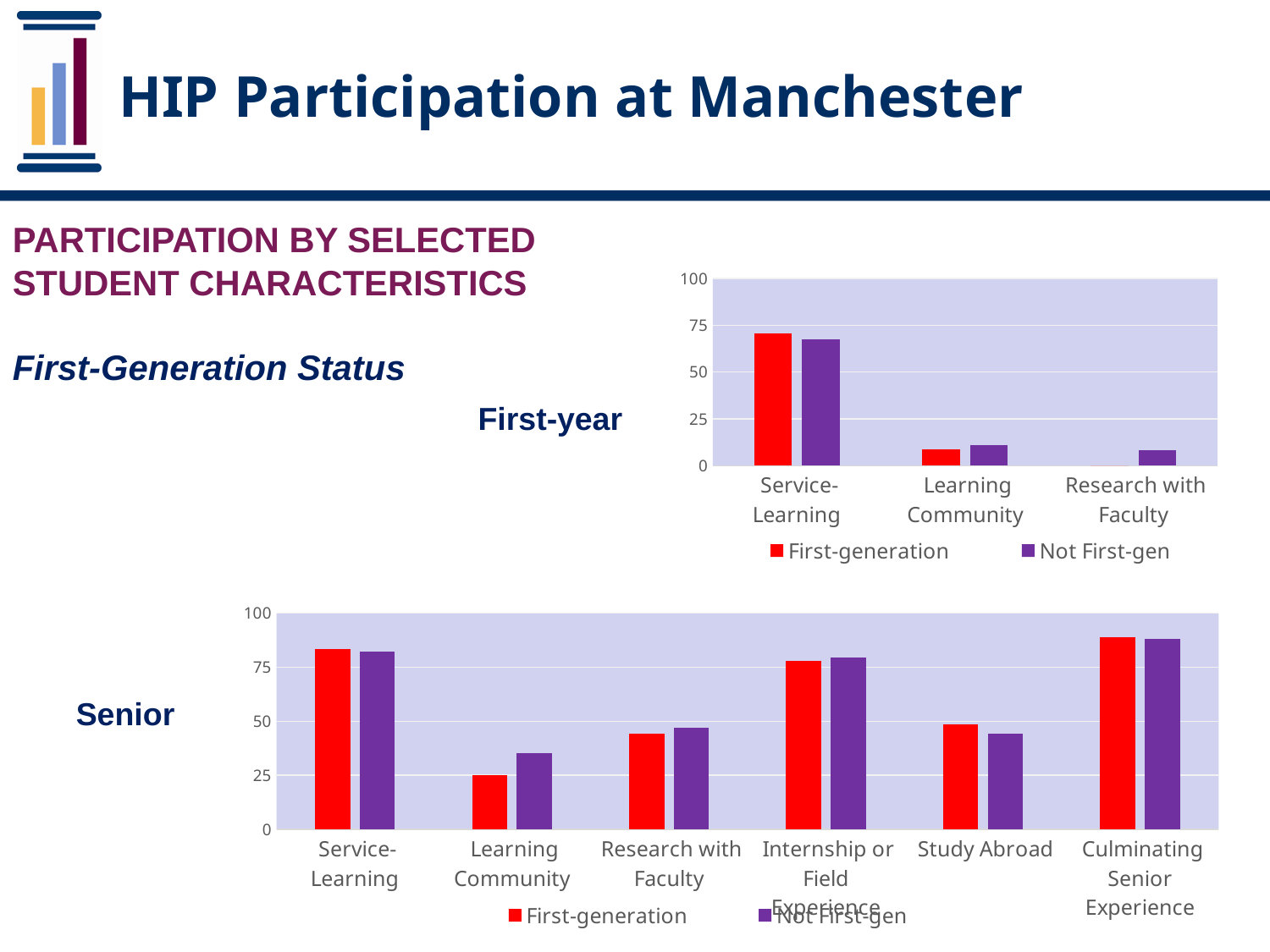
What kind of chart is the First-year chart? bar chart In the Senior chart, is the Not First-gen value for Learning Community greater or less than 25? greater In the Senior chart, is the First-generation value for Culminating Senior Experience greater or less than 75? greater In the First-year chart, is the First-generation value for Service-Learning greater or less than 50? greater In the Senior chart, which is larger for Learning Community: First-generation or Not First-gen? Not First-gen How many categories are shown on the Senior chart? 6 In the First-year chart, which category has the highest First-generation participation? Service-Learning How many categories are shown on the First-year chart? 3 How many series does the legend of the Senior chart list? 2 In the Senior chart, which category has the lowest First-generation participation? Learning Community Which colour represents the Not First-gen series in the Senior chart? purple